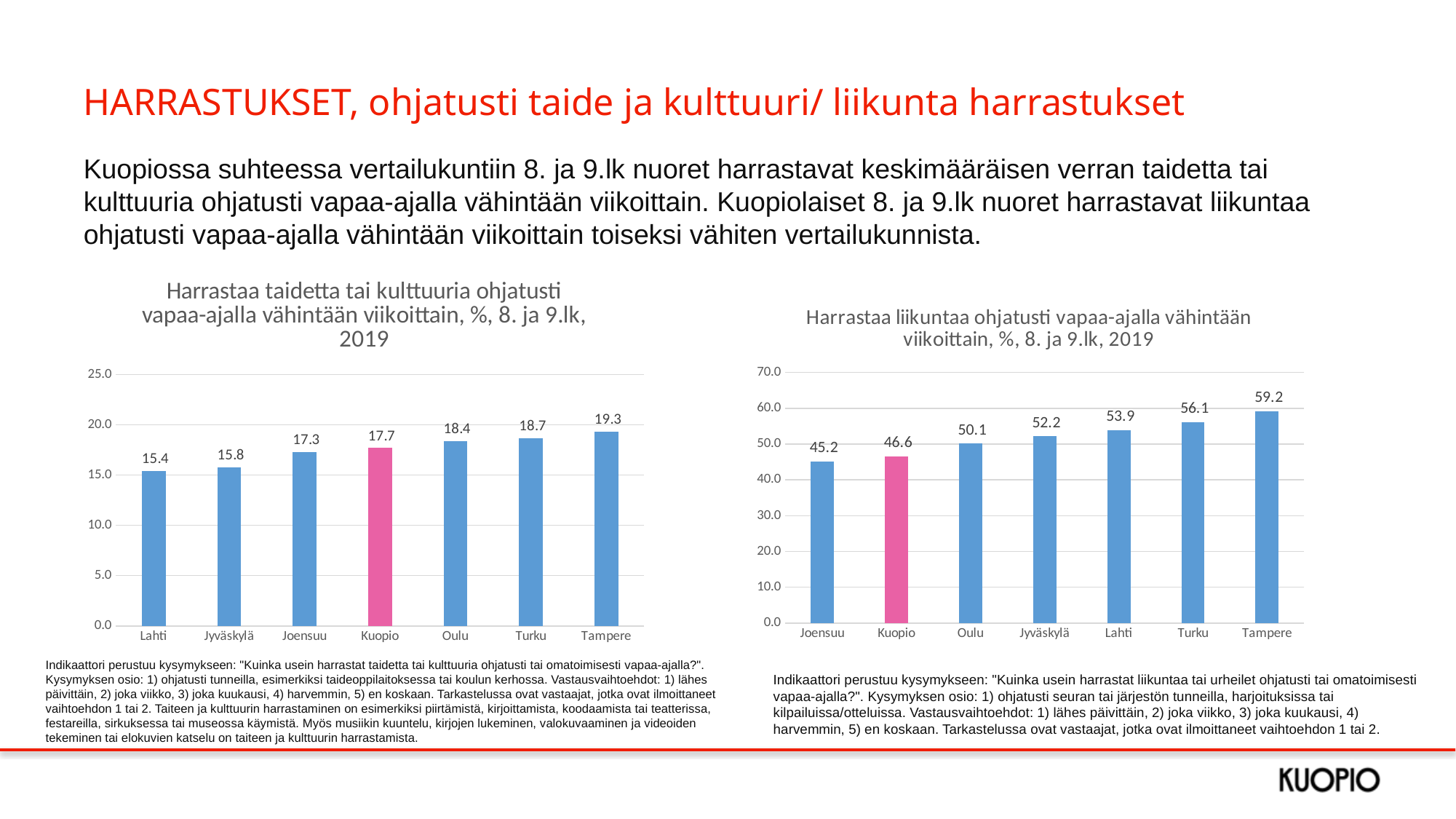
In the right chart (Harrastaa liikuntaa ohjatusti), what is the value for Kuopio? 46.6 In the right chart (Harrastaa liikuntaa ohjatusti), what is the difference between Tampere and Joensuu? 14.0 In the right chart (Harrastaa liikuntaa ohjatusti), which city has the highest value? Tampere In the left chart (Harrastaa taidetta tai kulttuuria ohjatusti), which is larger, the value for Oulu or the value for Joensuu? Oulu In the right chart (Harrastaa liikuntaa ohjatusti), which city's bar is highlighted in pink? Kuopio In the right chart (Harrastaa liikuntaa ohjatusti), which city has the lowest value? Joensuu In the left chart (Harrastaa taidetta tai kulttuuria ohjatusti), which city has the highest value? Tampere In the left chart (Harrastaa taidetta tai kulttuuria ohjatusti), which city has the lowest value? Lahti In the left chart (Harrastaa taidetta tai kulttuuria ohjatusti), what is the difference between Tampere and Kuopio? 1.6 How many cities are shown in the right chart (Harrastaa liikuntaa ohjatusti)? 7 What kind of chart is the left chart (Harrastaa taidetta tai kulttuuria ohjatusti)? Bar chart In the left chart (Harrastaa taidetta tai kulttuuria ohjatusti), what is the value for Kuopio? 17.7